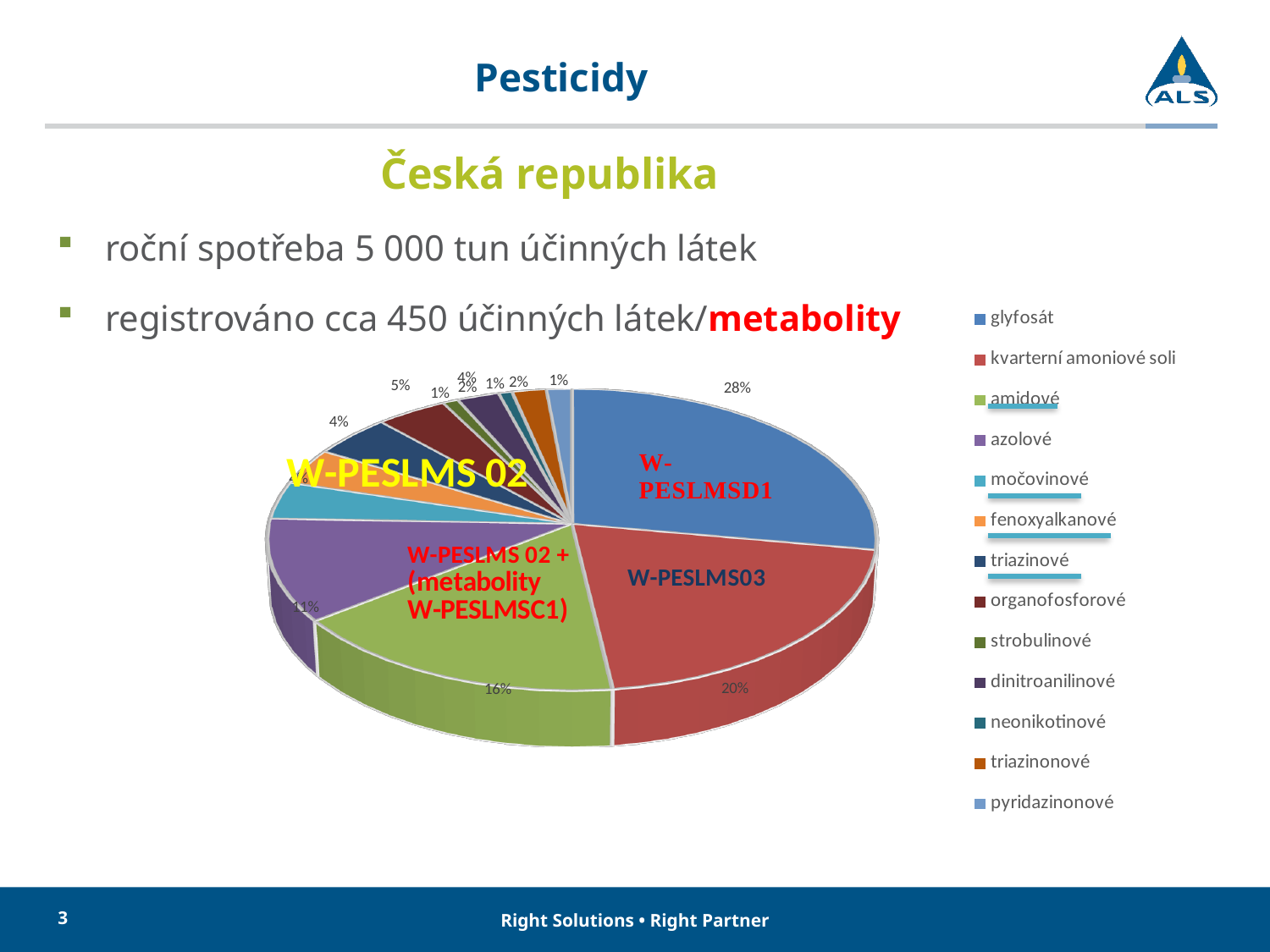
What is the combined share of glyfosát and kvarterní amoniové soli? 48% Which is larger, the slice for amidové or the slice for azolové? amidové What is the difference in percentage points between glyfosát and kvarterní amoniové soli? 8 What is the value shown for amidové? 16% What kind of chart is shown on the slide? pie chart Which legend entry is listed last in the pie chart's legend? pyridazinonové What colour is the glyfosát slice in the pie chart? blue What is the value shown for azolové? 11% What is the value shown for kvarterní amoniové soli? 20% How many categories does the legend of the pie chart list? 13 What share of the pie does glyfosát have? 28% Which category has the largest slice in the pie chart? glyfosát